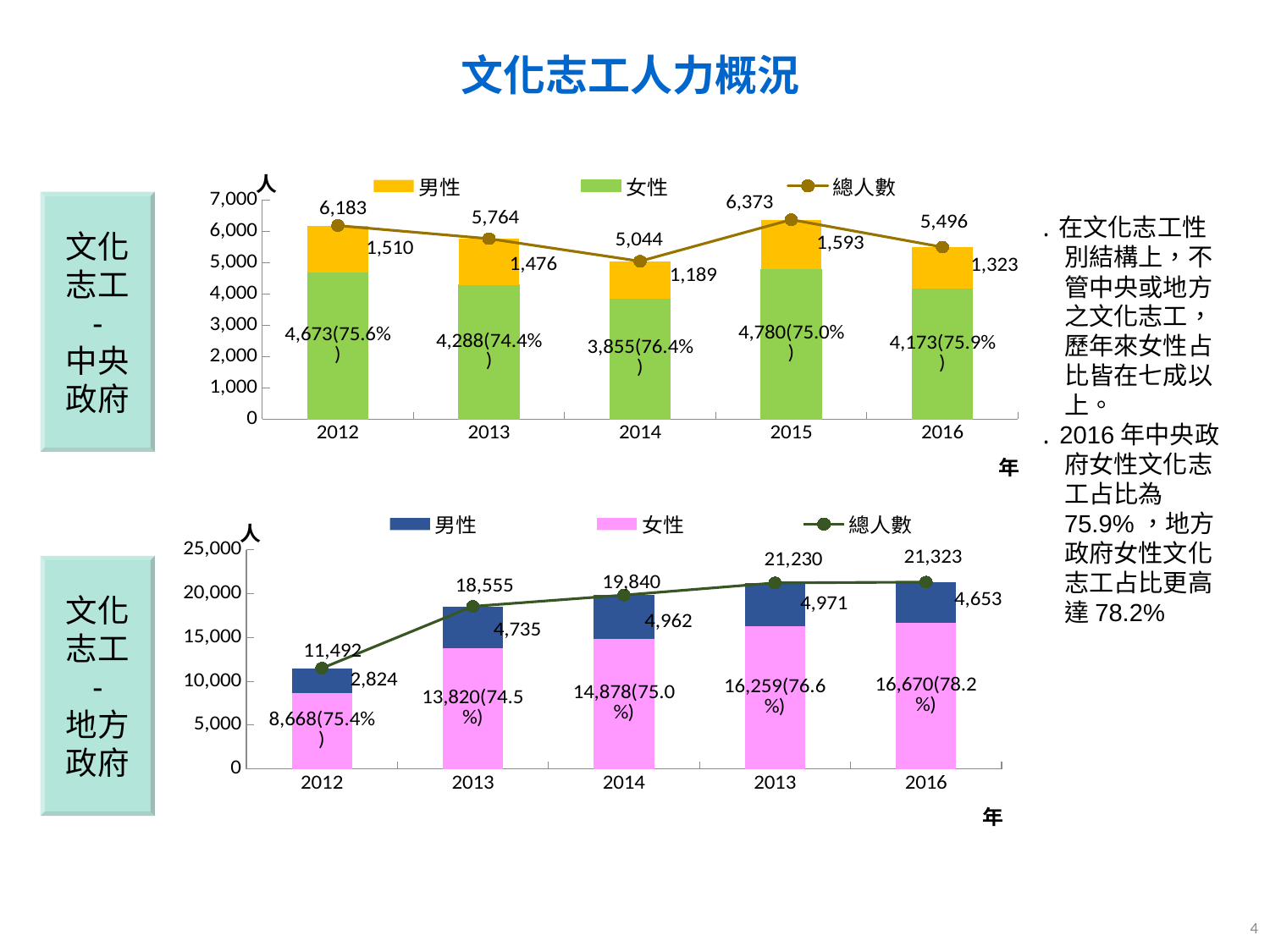
In the top chart (文化志工-中央政府), what is the difference between the total number of volunteers in 2015 and in 2016? 877 In the top chart (文化志工-中央政府), how many male volunteers (男性) were there in 2014? 1,189 In the bottom chart (文化志工-地方政府), which year had the highest total number of volunteers? 2016 In the bottom chart (文化志工-地方政府), how many female volunteers (女性) were there in 2016? 16,670 In the top chart (文化志工-中央政府), what percentage share did female volunteers have in 2016? 75.9% In the top chart (文化志工-中央政府), what was the total number of volunteers (總人數) in 2015? 6,373 In the bottom chart (文化志工-地方政府), what was the total number of volunteers in 2012? 11,492 What type of chart is the bottom chart (文化志工-地方政府)? Stacked bar chart with a line In the bottom chart (文化志工-地方政府), is the total number of volunteers in 2014 greater or less than 20,000? less How many series does the legend of the top chart (文化志工-中央政府) list? 3 In the top chart (文化志工-中央政府), which year had the lowest total number of volunteers? 2014